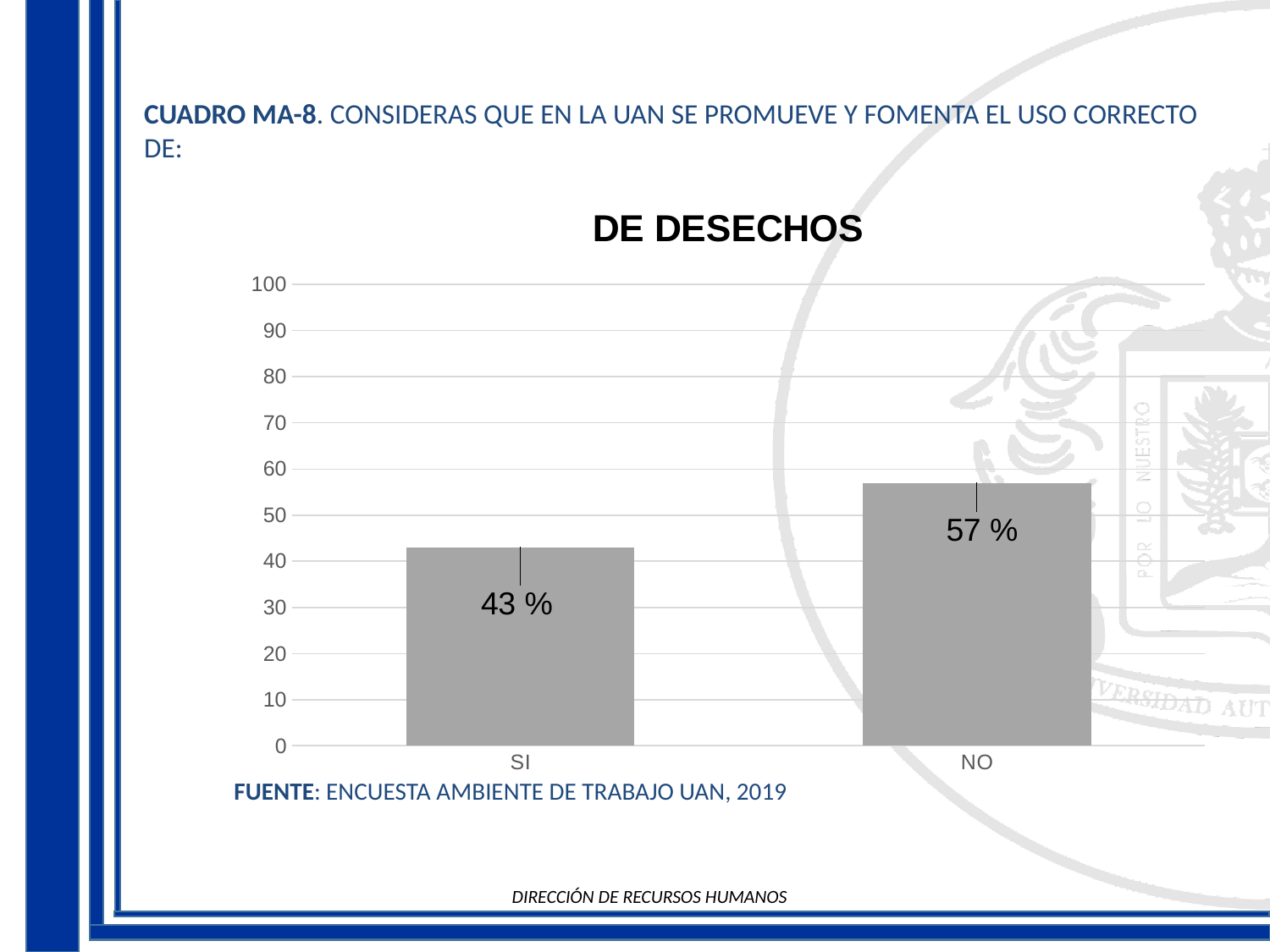
What is the value for SI in the DE DESECHOS chart? 43 % How many categories are shown in the DE DESECHOS chart? 2 Is the value for SI in the DE DESECHOS chart greater or less than 50? less What is the title of the chart on the slide? DE DESECHOS What is the value for NO in the DE DESECHOS chart? 57 % Which category has the highest value in the DE DESECHOS chart? NO What kind of chart is the DE DESECHOS chart? bar chart Which category has the lowest value in the DE DESECHOS chart? SI What is the maximum value shown on the vertical axis of the DE DESECHOS chart? 100 Which is larger in the DE DESECHOS chart, the value for SI or the value for NO? NO Is the value for NO in the DE DESECHOS chart greater or less than 50? greater What is the difference between the values for NO and SI in the DE DESECHOS chart? 14 %